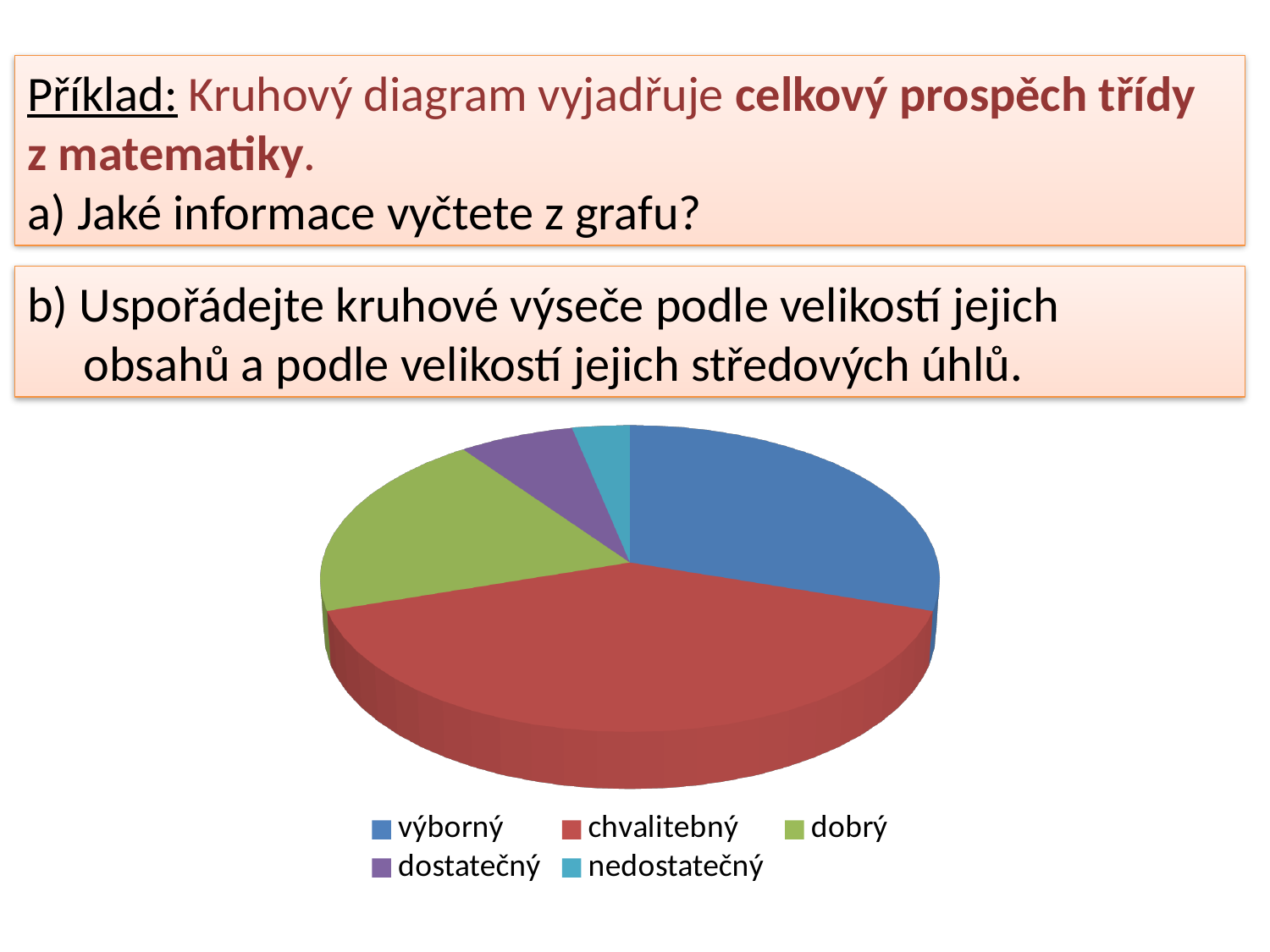
Which category is shown in blue in the pie chart? výborný What colour is the slice for chvalitebný in the pie chart? red Which slice is larger, dostatečný or nedostatečný? dostatečný What kind of chart is shown on the slide? pie chart How many slices does the pie chart have? 5 How many entries does the legend of the pie chart list? 5 Which slice is larger, výborný or dobrý? výborný Which slice is larger, dobrý or dostatečný? dobrý Which category has the smallest slice in the pie chart? nedostatečný Which category has the largest slice in the pie chart? chvalitebný